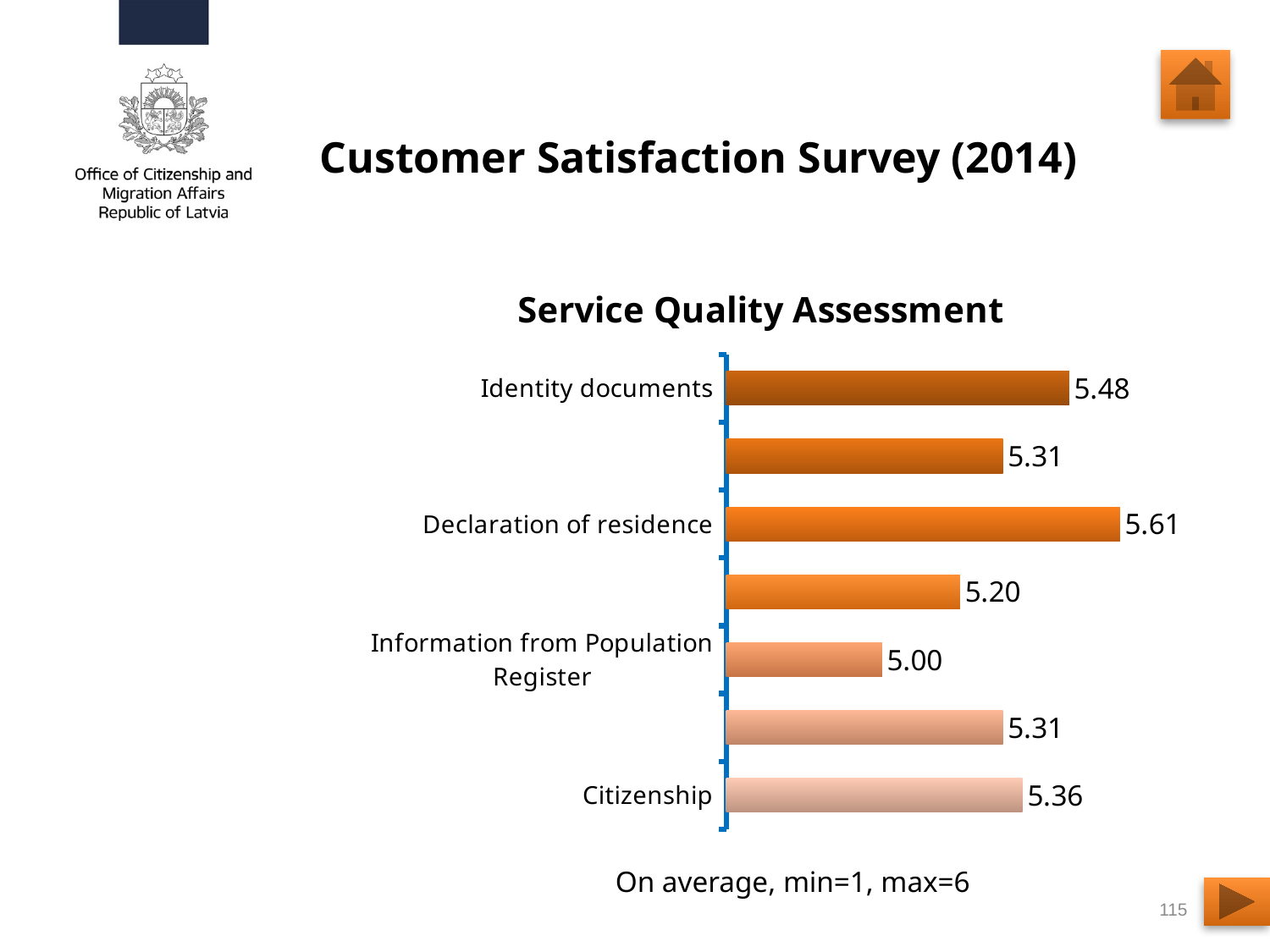
What is the value for Information from Population Register? 5.00 Which labelled category has the highest value? Declaration of residence Which labelled category has the lowest value? Information from Population Register Which is larger, the value for Identity documents or the value for Citizenship? Identity documents What is the value for Citizenship? 5.36 What is the title of the chart? Service Quality Assessment What is the value for Identity documents? 5.48 What is the value for Declaration of residence? 5.61 What kind of chart is shown under the title "Service Quality Assessment"? bar chart What is the difference between the values for Declaration of residence and Information from Population Register? 0.61 What is the difference between the values for Identity documents and Citizenship? 0.12 How many bars are plotted in the chart? 7